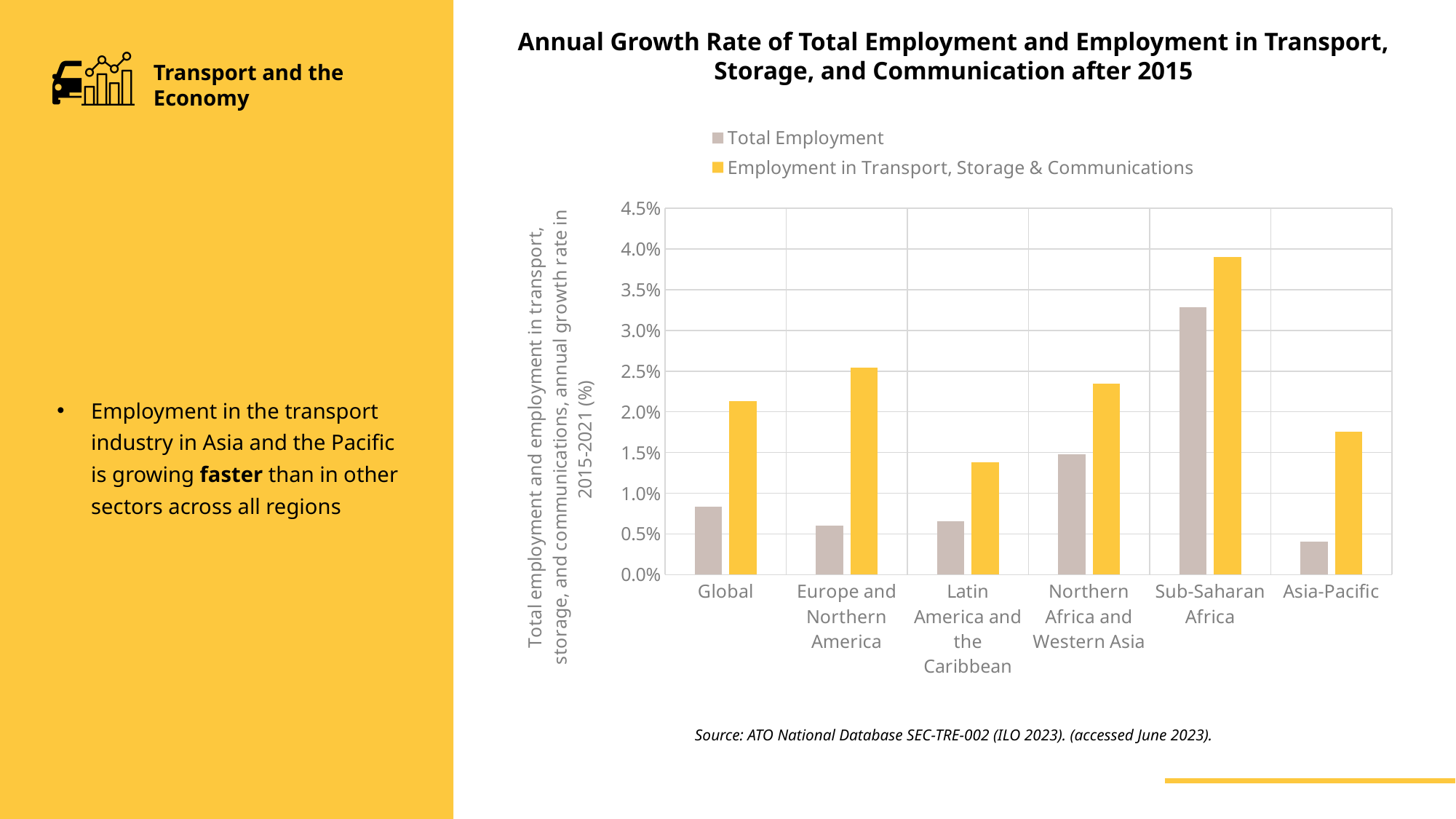
Is the Total Employment value for Asia-Pacific greater or less than 0.5%? less How many series does the legend list? 2 Which region has the lowest growth rate for Total Employment? Asia-Pacific Is the Employment in Transport, Storage & Communications value for Sub-Saharan Africa greater or less than 3.5%? greater What type of chart is shown on the slide? bar chart What colour are the bars for Employment in Transport, Storage & Communications? yellow Which is larger: the Total Employment growth rate for Global or for Europe and Northern America? Global How many regions are shown on the x axis? 6 Which is larger: the Employment in Transport, Storage & Communications growth rate for Northern Africa and Western Asia or for Latin America and the Caribbean? Northern Africa and Western Asia Which region has the highest growth rate for Employment in Transport, Storage & Communications? Sub-Saharan Africa Which region has the lowest growth rate for Employment in Transport, Storage & Communications? Latin America and the Caribbean Is the Total Employment value for Northern Africa and Western Asia greater or less than 1.0%? greater